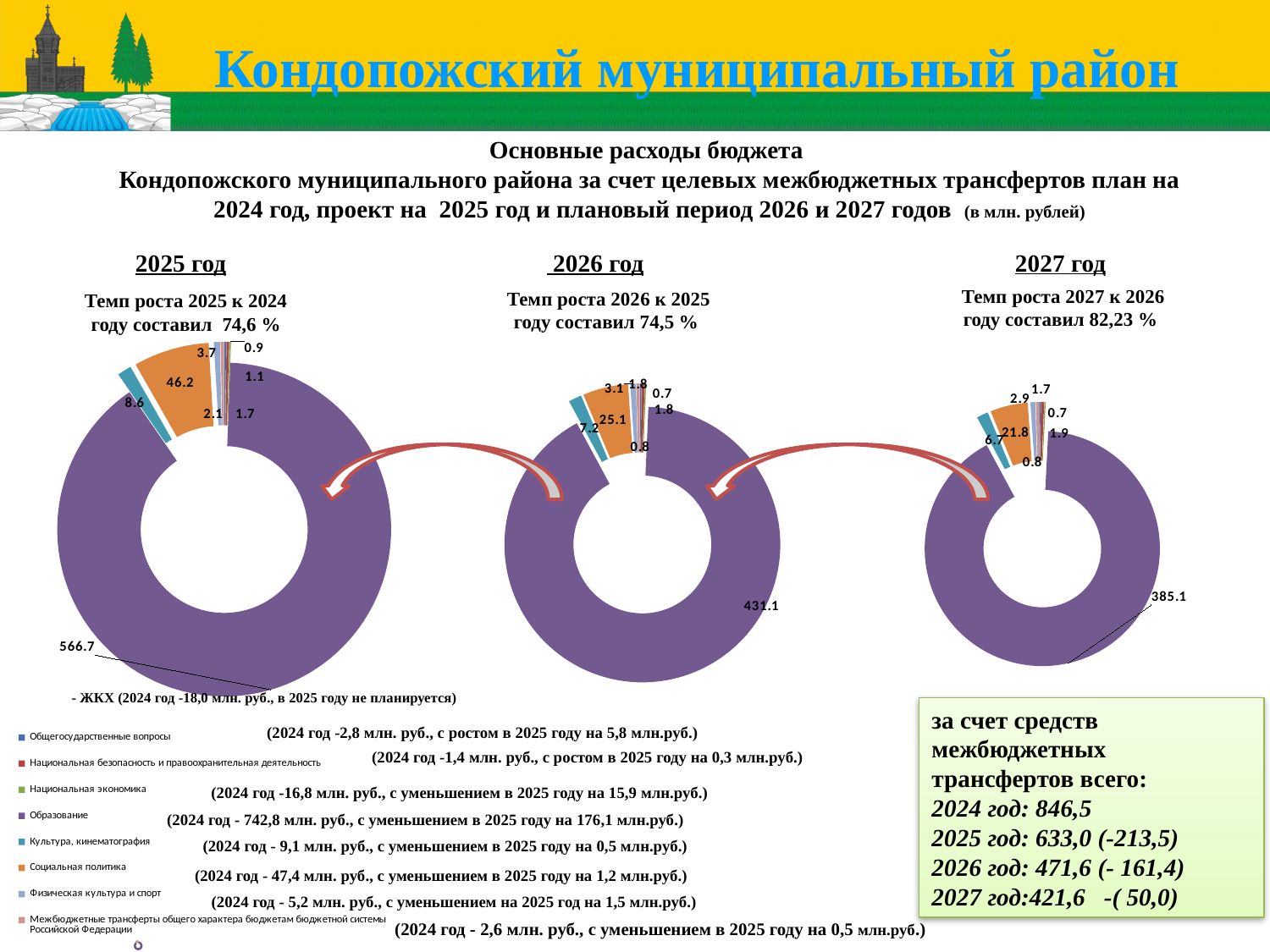
How many categories does the legend list? 8 What is the difference between the largest slice in the 2026 год chart and the largest slice in the 2027 год chart? 46.0 In the 2025 год chart, what is the value of the largest slice? 566.7 Does the value of the largest slice rise or fall from the 2025 год chart to the 2027 год chart? Fall In the 2025 год chart, what is the value of the orange slice (Социальная политика)? 46.2 What is the difference between the largest slice in the 2025 год chart and the largest slice in the 2026 год chart? 135.6 In the 2027 год chart, what is the value of the teal slice (Культура, кинематография)? 6.7 In the 2027 год chart, what is the value of the largest slice? 385.1 What kind of chart is used for each year on the slide? Pie (donut) chart In the 2026 год chart, what is the value of the orange slice (Социальная политика)? 25.1 Which is larger: the orange slice in the 2025 год chart or the orange slice in the 2026 год chart? 2025 год (46.2) In the 2026 год chart, what is the value of the largest slice? 431.1